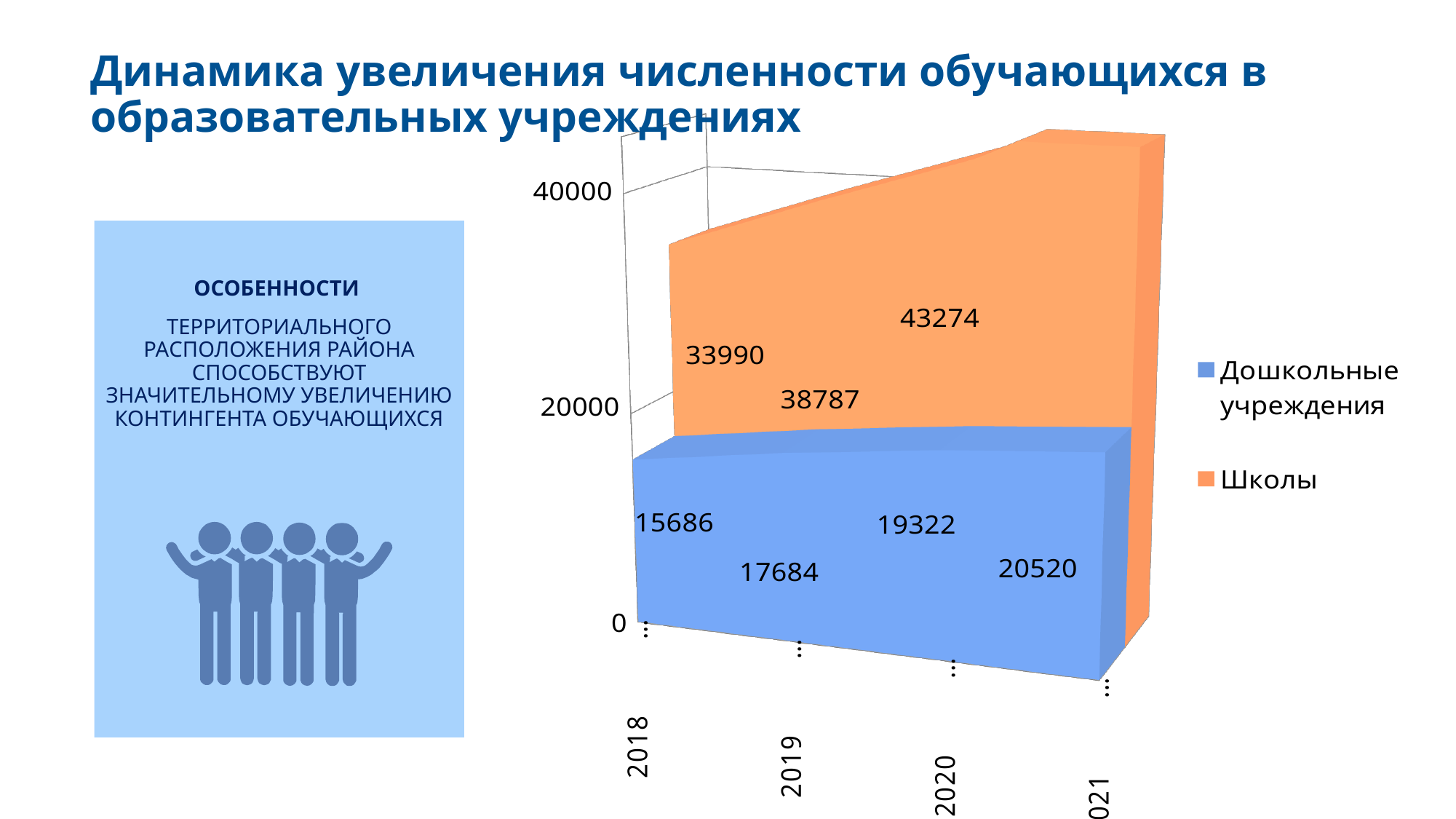
How many series does the legend list? 2 What is the value for Дошкольные учреждения in 2018? 15686 What is the value for Школы in 2019? 38787 In which year is the value for Дошкольные учреждения highest? 2021 What is the value for Дошкольные учреждения in 2021? 20520 In 2019, which series has the larger value, Школы or Дошкольные учреждения? Школы What kind of chart is shown on the slide? area chart What is the difference between the Школы values for 2020 and 2018? 9284 Do the values for Дошкольные учреждения rise or fall from 2018 to 2021? rise What is the value for Школы in 2020? 43274 In which year is the value for Школы lowest among the labelled values? 2018 What is the difference between the Дошкольные учреждения values for 2021 and 2018? 4834